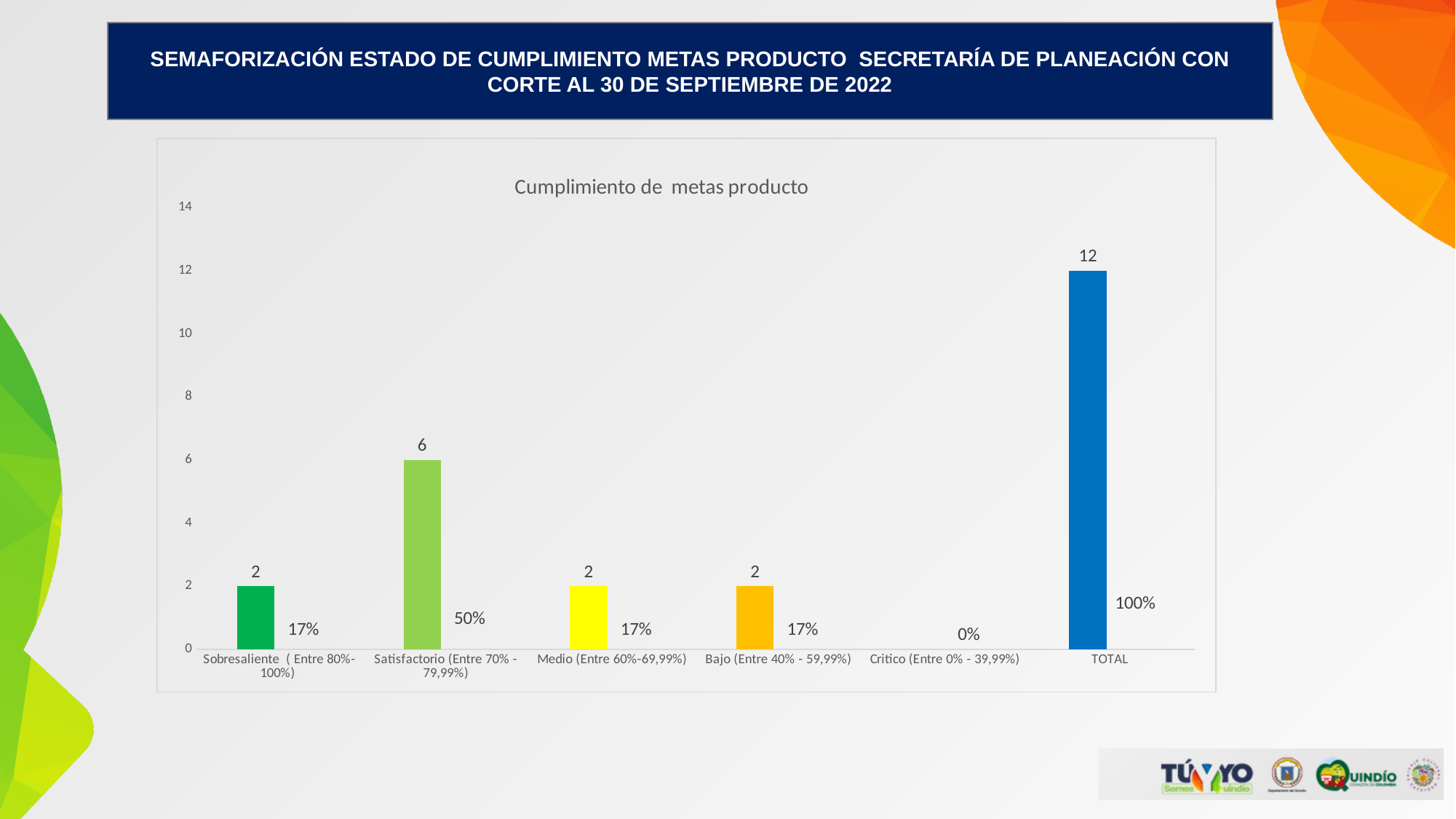
Is the value for TOTAL greater or less than 10? greater What is the count value for TOTAL? 12 What percentage is shown for Satisfactorio (Entre 70% - 79,99%)? 50% What percentage is shown for Bajo (Entre 40% - 59,99%)? 17% What kind of chart is shown on the slide? bar chart Which is larger, the count for Satisfactorio (Entre 70% - 79,99%) or the count for Medio (Entre 60%-69,99%)? Satisfactorio (Entre 70% - 79,99%) What is the title of the chart? Cumplimiento de metas producto What is the count value for Satisfactorio (Entre 70% - 79,99%)? 6 What is the difference between the count for TOTAL and the count for Satisfactorio (Entre 70% - 79,99%)? 6 Excluding TOTAL, which category has the highest count? Satisfactorio (Entre 70% - 79,99%) How many categories are shown on the x axis of the chart? 6 What percentage is shown for Critico (Entre 0% - 39,99%)? 0%